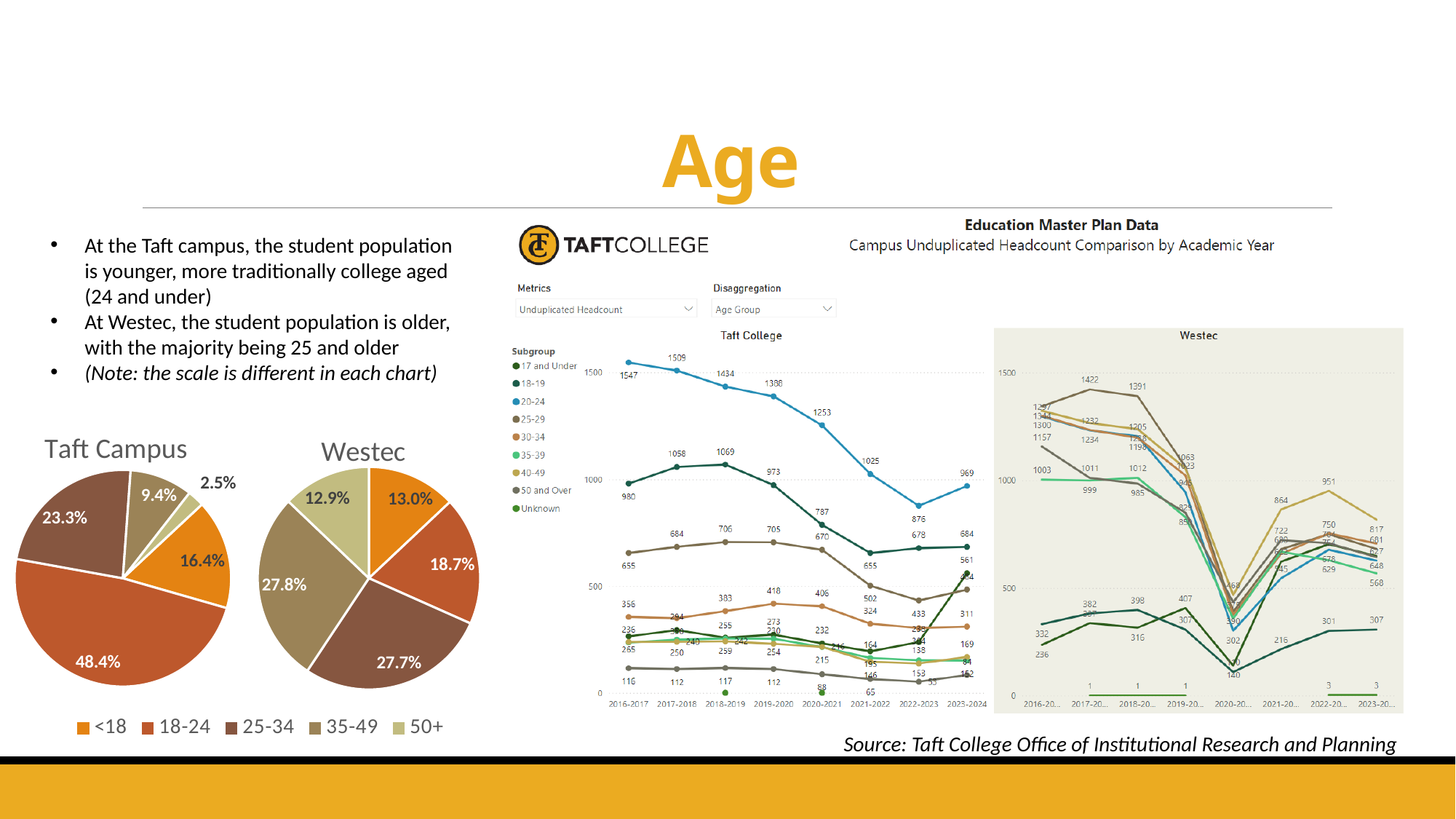
In the Westec pie chart, which is larger: the 18-24 slice or the <18 slice? 18-24 In the Taft College line chart, what is the 20-24 headcount for 2016-2017? 1547 In the Westec pie chart, what share of students are aged 25-34? 27.7% In the Taft College line chart, what is the 20-24 headcount for 2023-2024? 969 In the Taft Campus pie chart, which age group has the largest slice? 18-24 In the Taft Campus pie chart, what is the difference in percentage points between the 18-24 slice and the 25-34 slice? 25.1 percentage points In the Taft Campus pie chart, what share of students are aged 18-24? 48.4% In the Taft College line chart, does the 20-24 headcount rise or fall from 2016-2017 to 2022-2023? Fall How many age groups does the legend below the pie charts list? 5 In the Taft Campus pie chart, which age group has the smallest slice? 50+ In the Westec pie chart, what share of students are aged 50+? 12.9% What kind of chart is the Taft Campus chart? Pie chart